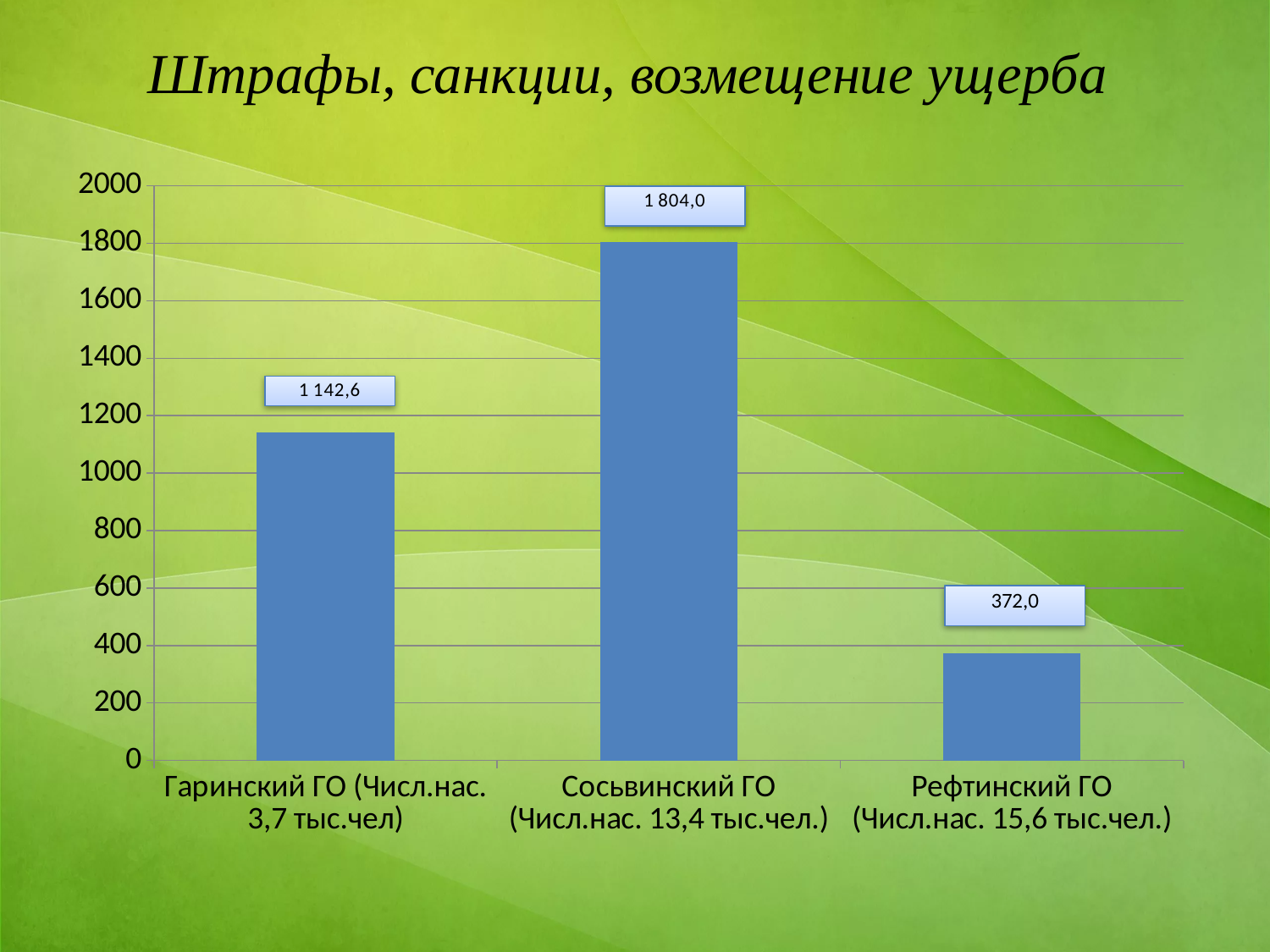
Which category has the highest value? Сосьвинский ГО What is the value for Гаринский ГО? 1 142,6 What is the difference between the values for Гаринский ГО and Рефтинский ГО? 770,6 What is the title of the slide? Штрафы, санкции, возмещение ущерба How many categories are shown in the chart? 3 Which category has the lowest value? Рефтинский ГО What is the difference between the values for Сосьвинский ГО and Гаринский ГО? 661,4 Which is larger, the value for Гаринский ГО or the value for Рефтинский ГО? Гаринский ГО Is the value for Рефтинский ГО greater or less than 400? less What kind of chart is shown on the slide? bar chart What is the value for Сосьвинский ГО? 1 804,0 What is the value for Рефтинский ГО? 372,0